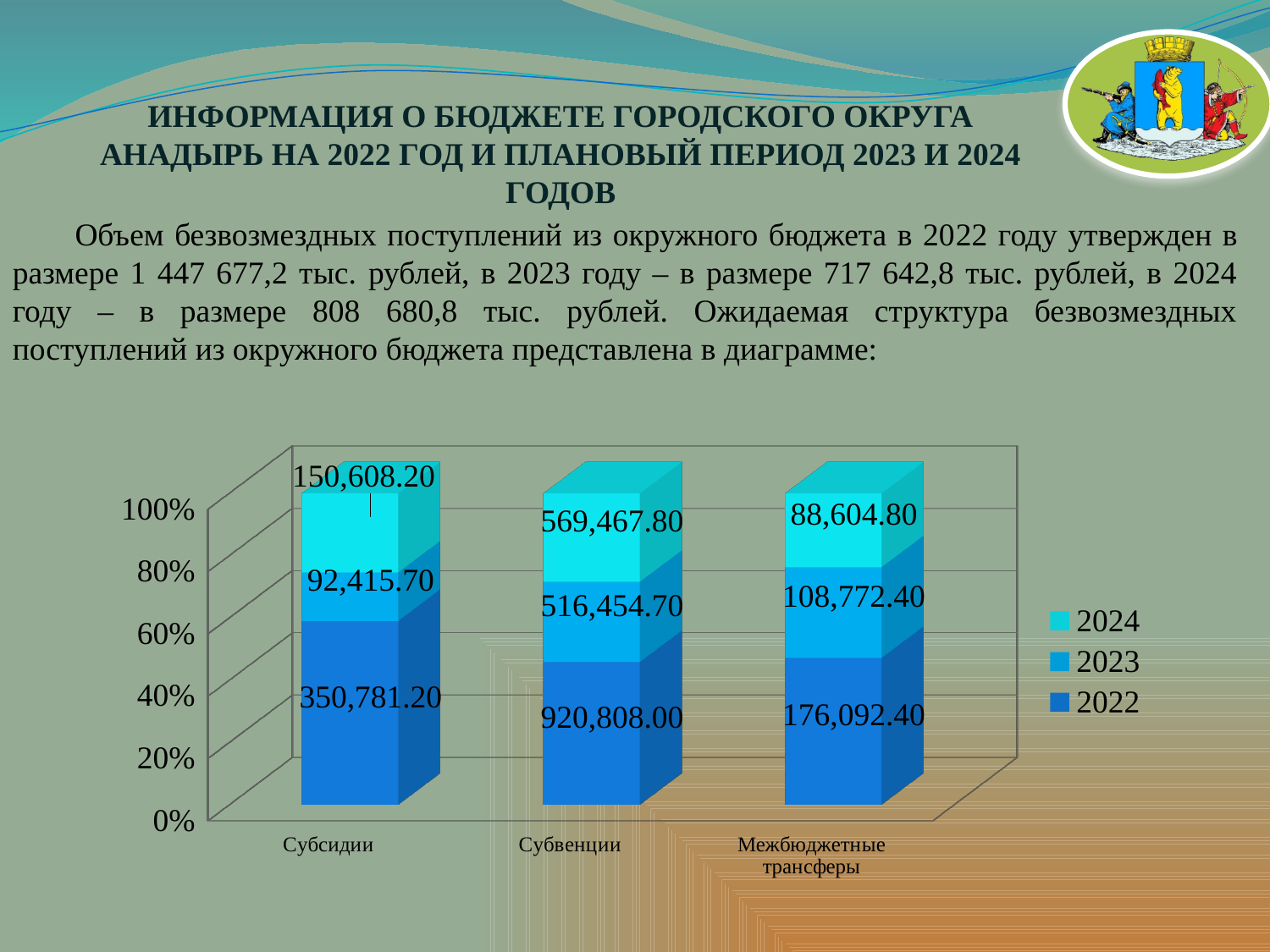
What is the total of the three labelled values in the Межбюджетные трансферы bar? 373,469.60 What is the value for 2023 in the Межбюджетные трансферы bar? 108,772.40 Which series is shown in the darkest blue colour at the bottom of each bar? 2022 What is the difference between the 2022 values for Субвенции and Субсидии? 570,026.80 How many categories are shown on the x axis? 3 Which category has the lowest value for the 2024 series? Межбюджетные трансферы Which category has the highest value for the 2022 series? Субвенции Which is larger: the 2023 value for Субсидии or the 2023 value for Межбюджетные трансферы? Межбюджетные трансферы How many series does the legend list? 3 What kind of chart is shown on the slide? Stacked bar chart What is the value for 2022 in the Субсидии bar? 350,781.20 What is the value for 2024 in the Субвенции bar? 569,467.80